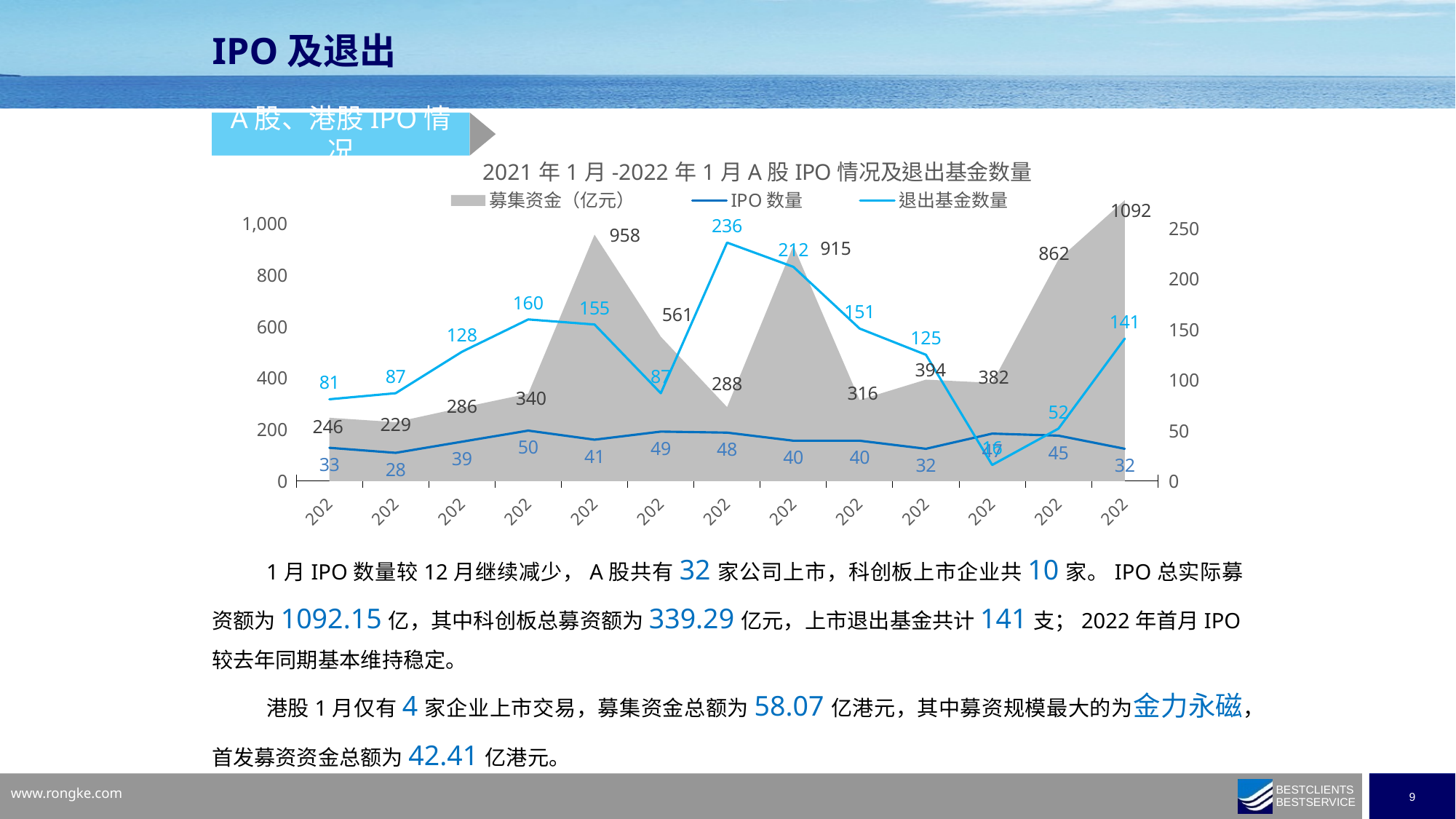
What is the highest value of 募集资金（亿元） shown in the chart? 1092 What is the lowest value of 募集资金（亿元） shown in the chart? 229 What is the highest value of IPO 数量 shown in the chart? 50 What is the difference between the highest and lowest 募集资金（亿元） values in the chart? 863 How many series does the chart legend list? 3 What is the lowest value of 退出基金数量 shown in the chart? 16 How many data points does each series in the chart have? 13 What is the lowest value of IPO 数量 shown in the chart? 28 What is the value of 退出基金数量 at the rightmost (last) data point of the chart? 141 What kind of chart is shown on the slide? Combined area and line chart What is the highest value of 退出基金数量 shown in the chart? 236 What is the chart's title? 2021年1月-2022年1月A股IPO情况及退出基金数量